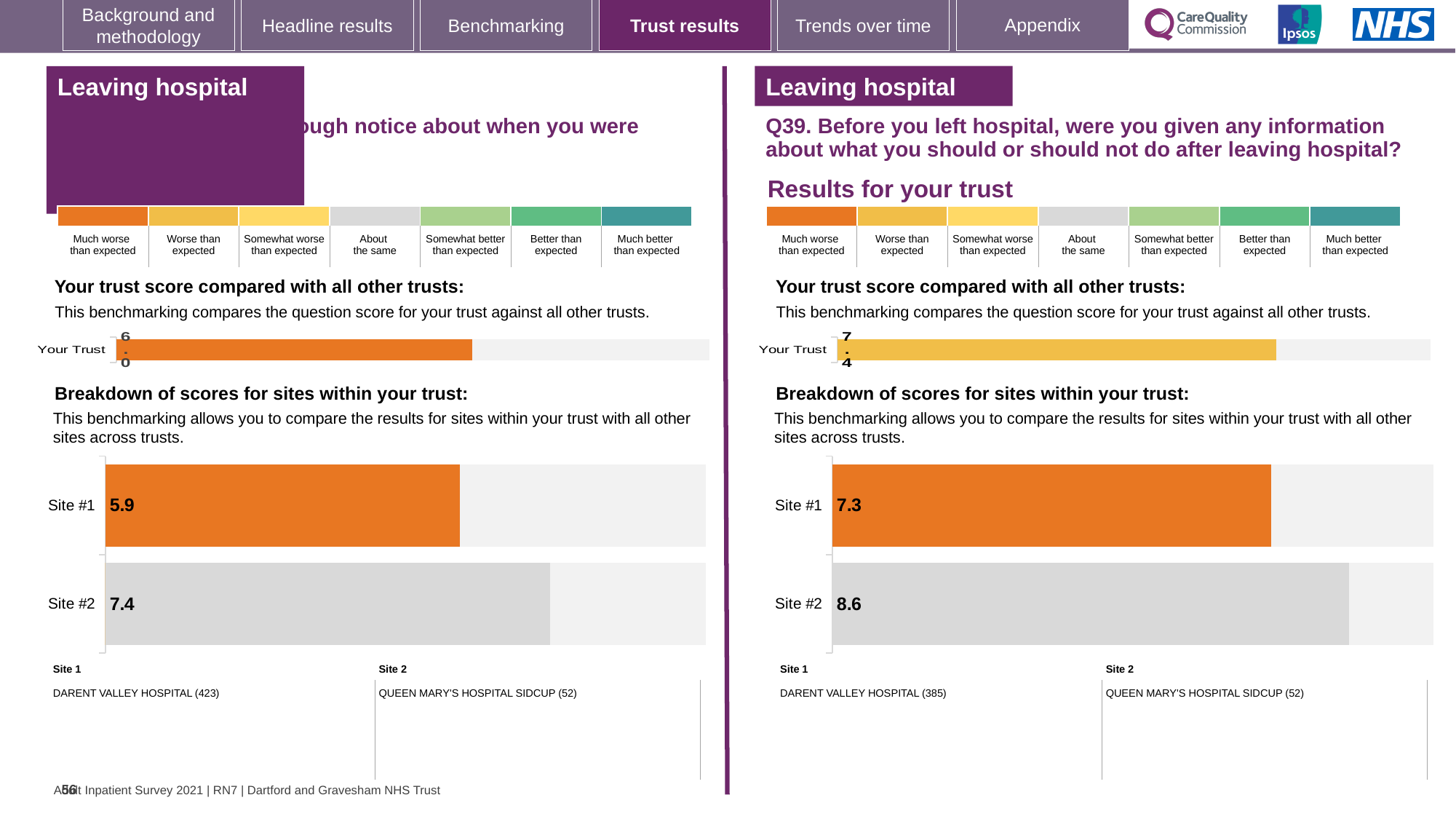
How many sites are shown on the right-hand (Q39) site breakdown chart? 2 On the right-hand (Q39) 'Your trust score compared with all other trusts' chart, what is the score for Your Trust? 7.4 On the left-hand 'Breakdown of scores for sites within your trust' chart, what is the score for Site #1? 5.9 On the right-hand (Q39) site breakdown chart, which site has the higher score? Site #2 On the left-hand 'Your trust score compared with all other trusts' chart, what is the score for Your Trust? 6.0 On the left-hand site breakdown chart, which site has the lower score? Site #1 On the right-hand (Q39) site breakdown chart, what is the difference between the Site #2 and Site #1 scores? 1.3 On the left-hand 'Breakdown of scores for sites within your trust' chart, what is the score for Site #2? 7.4 What type of chart is used for the site breakdown on the right-hand (Q39) side of the slide? Bar chart On the left-hand site breakdown chart, what is the difference between the Site #2 and Site #1 scores? 1.5 On the right-hand (Q39) 'Breakdown of scores for sites within your trust' chart, what is the score for Site #1? 7.3 On the right-hand (Q39) 'Breakdown of scores for sites within your trust' chart, what is the score for Site #2? 8.6